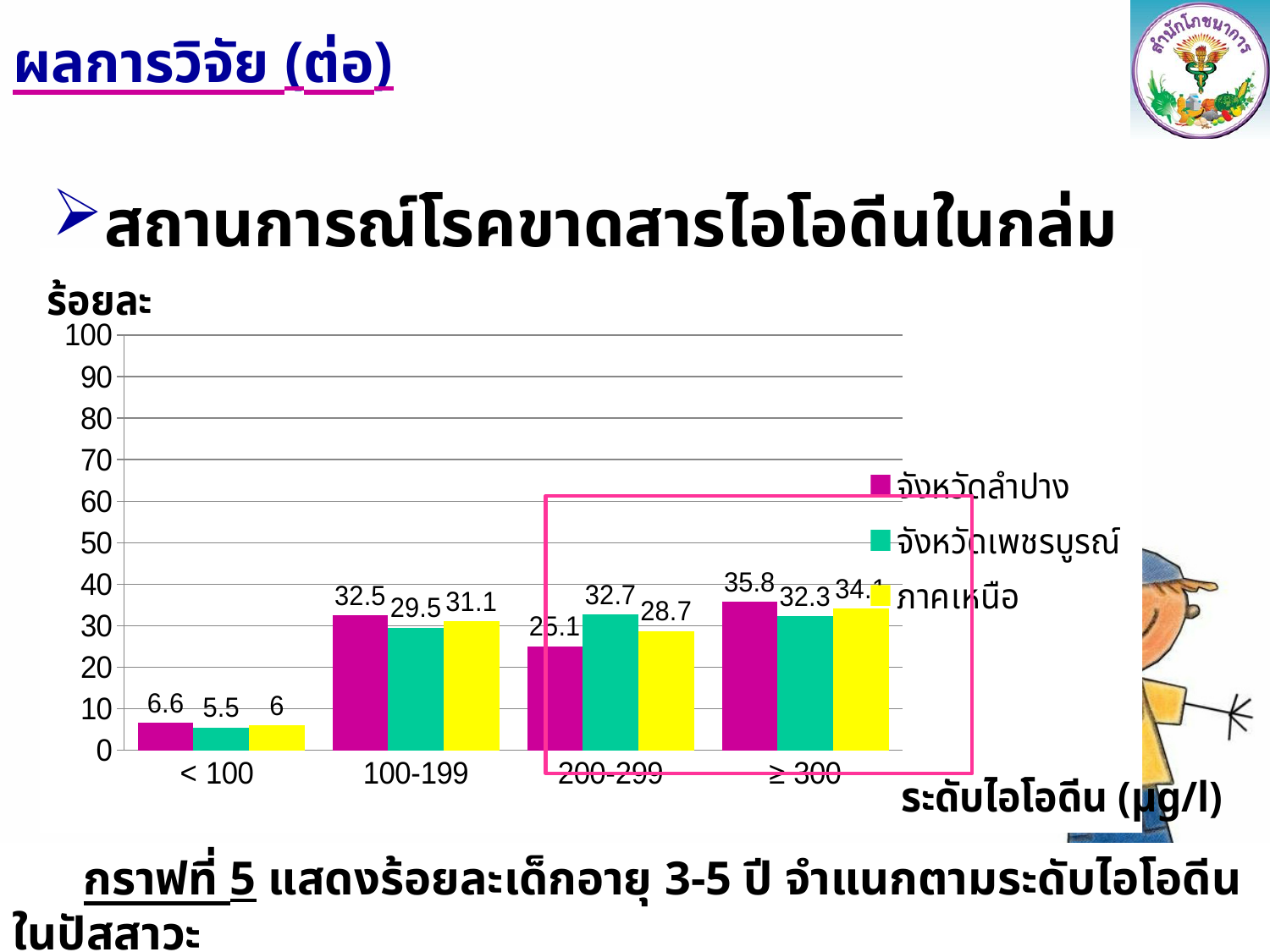
What is the value for จังหวัดลำปาง in the ≥ 300 category? 35.8 Which category has the lowest value for จังหวัดเพชรบูรณ์? < 100 In the 100-199 category, which is larger: จังหวัดลำปาง or จังหวัดเพชรบูรณ์? จังหวัดลำปาง What is the value for ภาคเหนือ in the 100-199 category? 31.1 How many series does the legend list? 3 What is the difference between จังหวัดเพชรบูรณ์ and จังหวัดลำปาง in the 200-299 category? 7.6 What is the value for จังหวัดลำปาง in the < 100 category? 6.6 How many iodine-level categories are shown on the x axis? 4 What is the value for จังหวัดเพชรบูรณ์ in the 200-299 category? 32.7 What kind of chart is shown on the slide? bar chart Is the value for ภาคเหนือ in the ≥ 300 category greater or less than 30? greater Which category has the highest value for จังหวัดลำปาง? ≥ 300